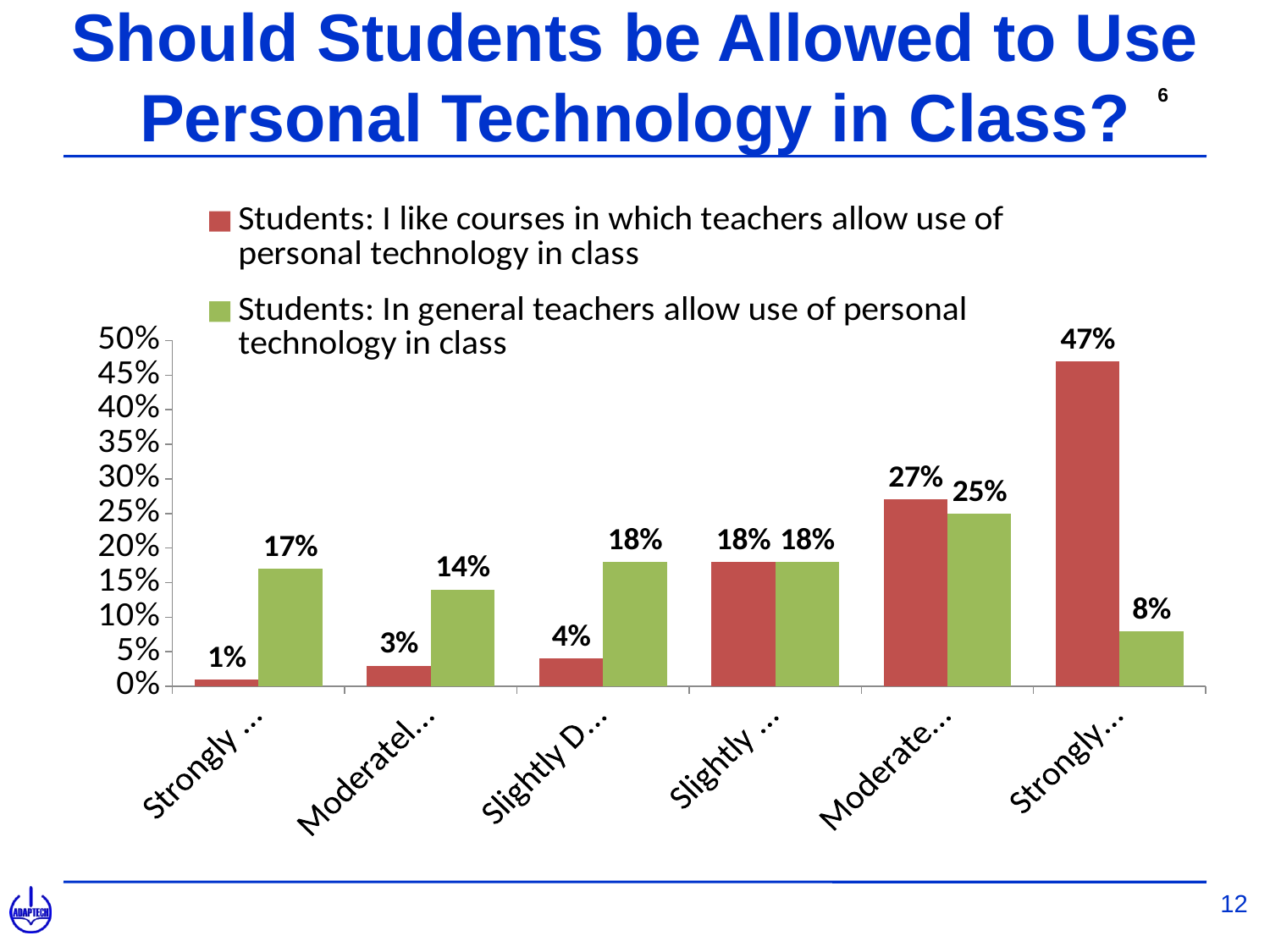
How many categories are plotted along the x axis? 6 What is the highest value in the red series? 47% For the rightmost category, what is the difference between the red series value and the green series value? 39 percentage points What is the value of the green series ("Students: In general teachers allow use of personal technology in class") for the leftmost category? 17% What is the highest value in the green series? 25% What kind of chart is shown on the slide? bar chart In the second category from the left, which series has the larger value, the red or the green? green What is the value of the red series ("Students: I like courses in which teachers allow use of personal technology in class") for the rightmost category? 47% Do the values of the red series rise or fall from left to right along the x axis? rise How many series does the legend list? 2 What is the value of the red series for the fifth category from the left? 27% What is the lowest value in the red series? 1%